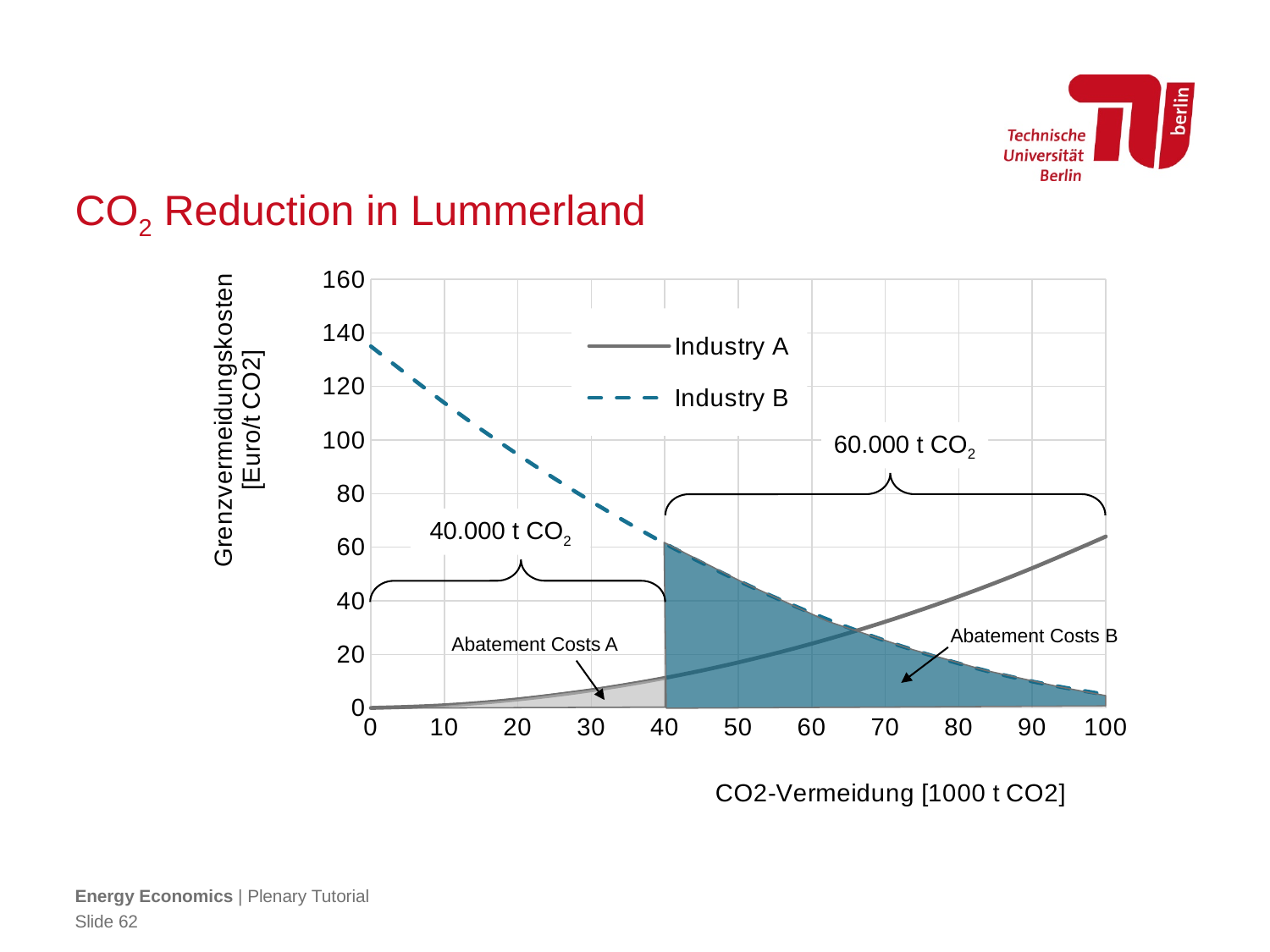
What is the label of the x axis? CO2-Vermeidung [1000 t CO2] Is the value for Industry A at 40 on the x axis greater or less than 20? less Does the Industry A line rise or fall as CO2-Vermeidung increases along the x axis? rise Is the value for Industry B at 100 on the x axis greater or less than 20? less Which two series are listed in the legend? Industry A and Industry B Is the value for Industry A at 100 on the x axis greater or less than 40? greater Does the Industry B line rise or fall as CO2-Vermeidung increases along the x axis? fall At 90 on the x axis, which series has the higher value, Industry A or Industry B? Industry A At 20 on the x axis, which series has the higher value, Industry A or Industry B? Industry B How many series does the legend list? 2 What kind of chart is shown on the slide? line chart